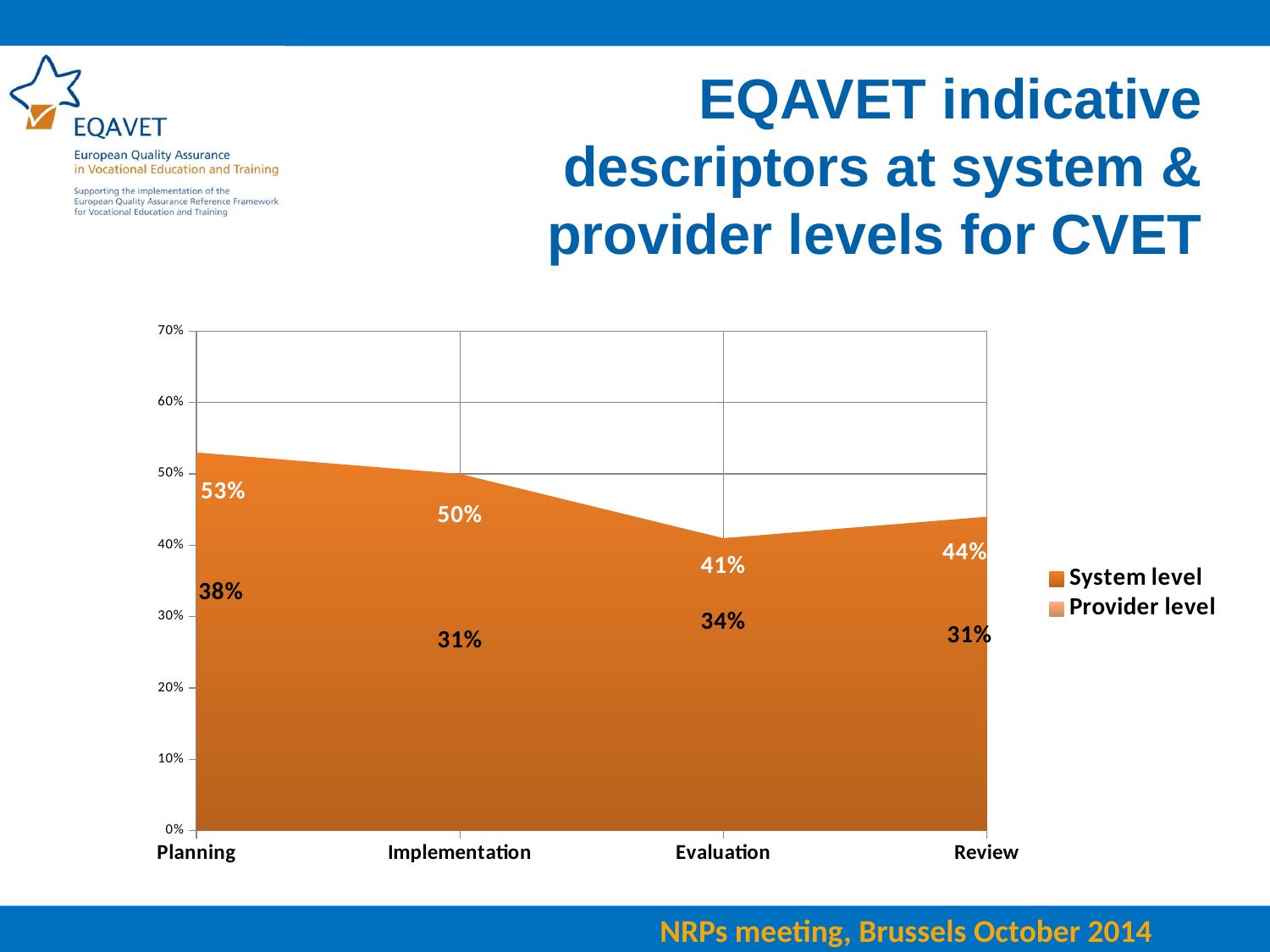
What is the higher of the two values labelled for Evaluation? 41% What is the higher of the two values labelled for Planning? 53% Is the higher value for Evaluation (41%) larger or smaller than the higher value for Review (44%)? Smaller Does the upper series rise or fall from Planning to Evaluation? Fall How many categories are shown along the x axis? 4 What are the two series named in the legend? System level and Provider level What is the lower of the two values labelled for Implementation? 31% How many series does the legend list? 2 What is the difference between the two values labelled for Planning (53% and 38%)? 15% What is the lower of the two values labelled for Review? 31% What kind of chart is shown on the slide? Area chart Which category has the highest labelled value on the chart? Planning